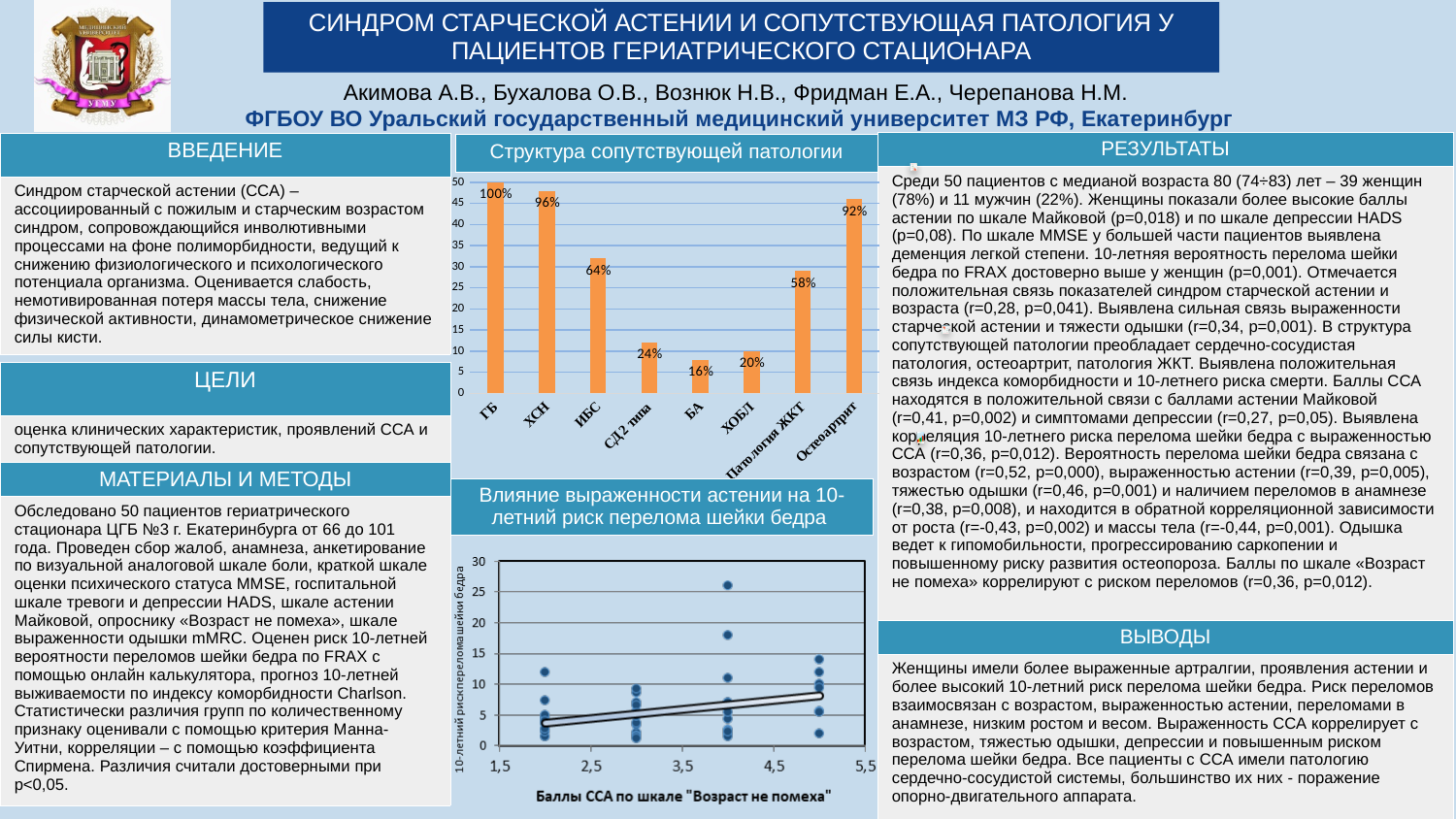
In the chart 'Структура сопутствующей патологии', how many categories are shown on the x axis? 8 In the chart 'Структура сопутствующей патологии', what is the data label for ГБ? 100% In the chart 'Структура сопутствующей патологии', what is the data label for СД2 типа? 24% In the chart 'Структура сопутствующей патологии', which category has the lowest value? БА In the chart 'Структура сопутствующей патологии', what is the data label for Остеоартрит? 92% In the chart 'Структура сопутствующей патологии', which category has the highest value? ГБ In the chart 'Структура сопутствующей патологии', which is larger: ХОБЛ or БА? ХОБЛ In the chart 'Структура сопутствующей патологии', what is the difference between the labels for ХСН and ИБС? 32% What kind of chart is 'Структура сопутствующей патологии'? Bar chart In the chart 'Влияние выраженности астении на 10-летний риск перелома шейки бедра', does the trend line rise or fall as the x-axis values increase? Rise In the chart 'Структура сопутствующей патологии', what is the data label for Патология ЖКТ? 58% What is the x-axis title of the chart 'Влияние выраженности астении на 10-летний риск перелома шейки бедра'? Баллы ССА по шкале "Возраст не помеха"